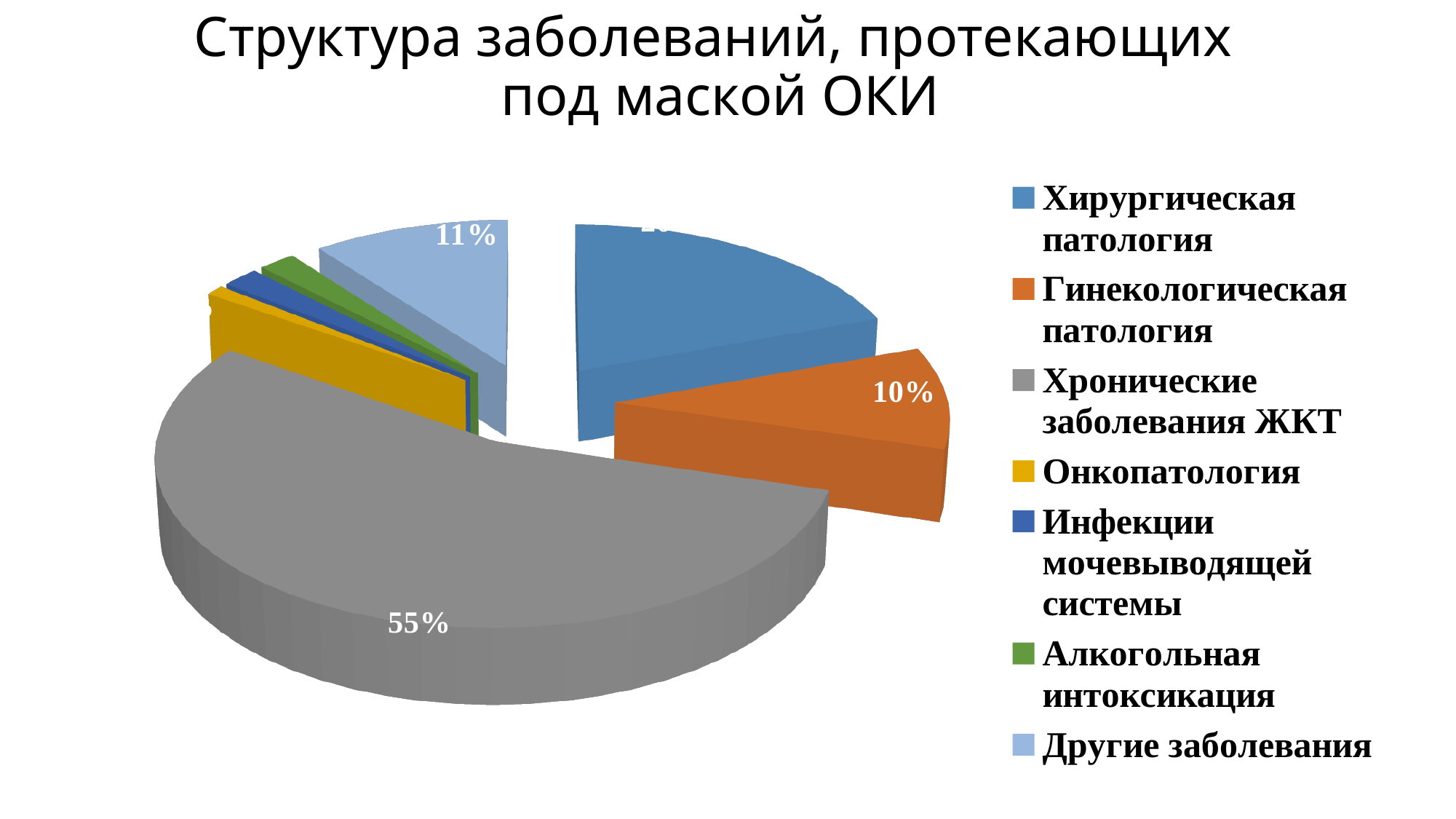
Which category has the largest share of the pie? Хронические заболевания ЖКТ What share of the pie is Гинекологическая патология? 10% How many categories does the legend list? 7 What colour is the slice for Онкопатология? yellow What share of the pie is Хронические заболевания ЖКТ? 55% What is the difference in percentage points between Хронические заболевания ЖКТ and Гинекологическая патология? 45 Is the share for Хронические заболевания ЖКТ greater or less than 50%? greater Which is larger: the share for Другие заболевания or the share for Гинекологическая патология? Другие заболевания What share of the pie is Другие заболевания? 11% What kind of chart is shown on the slide? pie chart What is the difference in percentage points between Другие заболевания and Гинекологическая патология? 1 What is the title of the chart? Структура заболеваний, протекающих под маской ОКИ